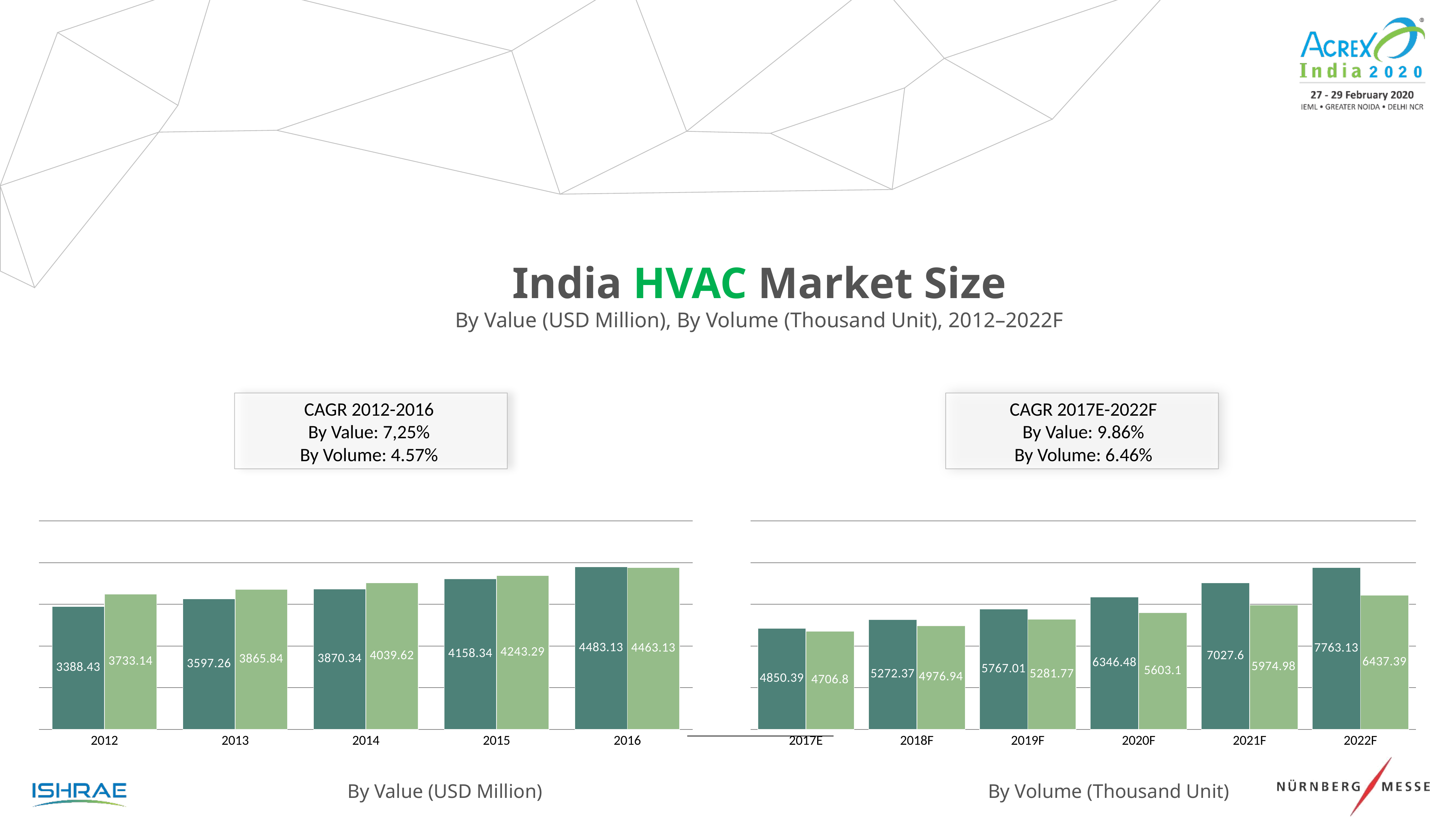
In the left chart (2012–2016), what is the dark green (By Value) figure for 2014? 3870.34 In the left chart (2012–2016), what is the light green (By Volume) figure for 2015? 4243.29 In the left chart (2012–2016), which year has the lowest dark green (By Value) bar? 2012 How many years are shown on the x axis of the right chart (2017E–2022F)? 6 In the right chart (2017E–2022F), what is the difference between the By Value and By Volume figures for 2022F? 1325.74 In the right chart (2017E–2022F), which year has the highest dark green (By Value) bar? 2022F What kind of chart is used on this slide for the India HVAC market size? Bar chart In the left chart (2012–2016), which is larger for 2012: the By Value figure or the By Volume figure? By Volume (3733.14) In the right chart (2017E–2022F), what is the light green (By Volume) figure for 2018F? 4976.94 In the right chart (2017E–2022F), what is the dark green (By Value) figure for 2020F? 6346.48 What CAGR by value is stated for the 2017E–2022F period? 9.86% In the left chart (2012–2016), do the dark green (By Value) bars rise or fall from 2012 to 2016? Rise